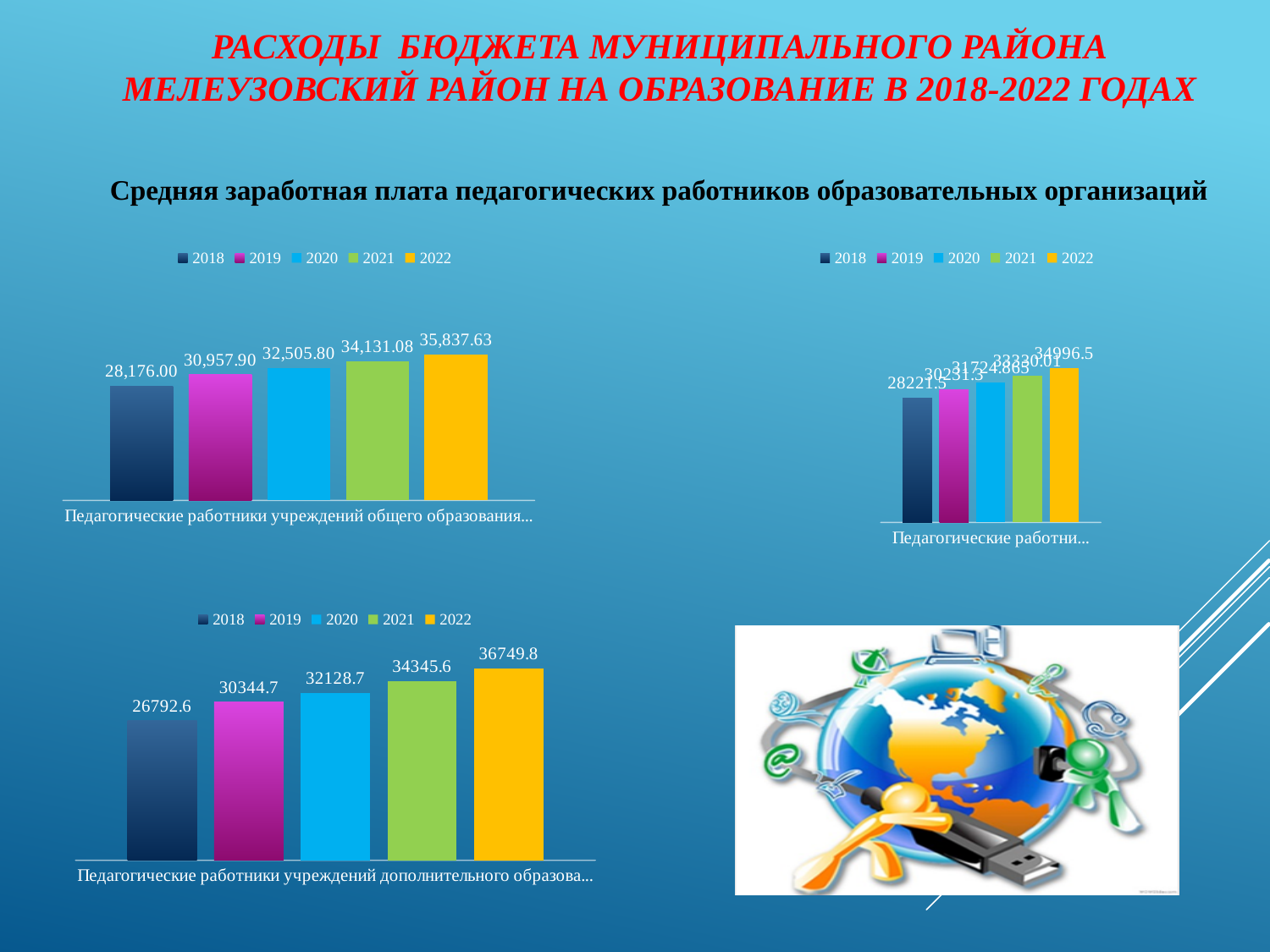
In the bottom-left chart (Педагогические работники учреждений дополнительного образования), which is larger, the value for 2020 or the value for 2022? 2022 In the top-left chart (Педагогические работники учреждений общего образования), what is the value for 2022? 35,837.63 In the top-right chart, what is the value for 2022? 34996.5 In the top-left chart (Педагогические работники учреждений общего образования), which year has the highest value? 2022 In the bottom-left chart (Педагогические работники учреждений дополнительного образования), which year has the lowest value? 2018 In the bottom-left chart (Педагогические работники учреждений дополнительного образования), do the values rise or fall from 2018 to 2022? rise In the bottom-left chart (Педагогические работники учреждений дополнительного образования), what is the value for 2019? 30344.7 In the bottom-left chart (Педагогические работники учреждений дополнительного образования), what is the value for 2021? 34345.6 What kind of chart is the bottom-left chart? bar chart How many series does the legend of the top-right chart list? 5 In the top-left chart (Педагогические работники учреждений общего образования), what is the difference between the 2022 and 2018 values? 7,661.63 In the top-left chart (Педагогические работники учреждений общего образования), what is the value for 2018? 28,176.00